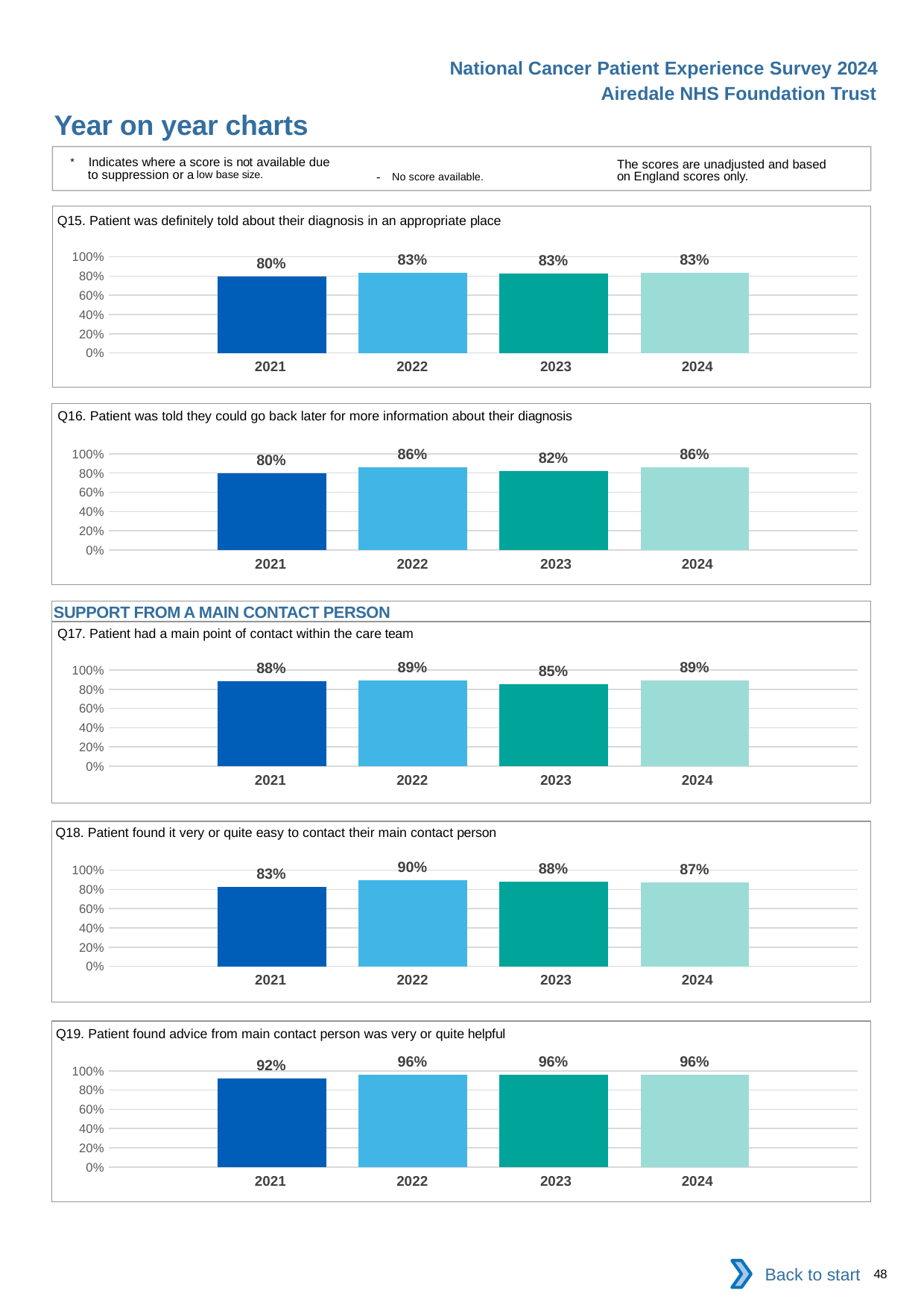
How many years are shown on the x axis of the Q15 chart (Patient was definitely told about their diagnosis in an appropriate place)? 4 In the Q18 chart (Patient found it very or quite easy to contact their main contact person), what is the difference between the 2022 and 2021 values? 7 percentage points In the Q19 chart (Patient found advice from main contact person was very or quite helpful), what is the value for 2021? 92% In the Q15 chart (Patient was definitely told about their diagnosis in an appropriate place), what is the value for 2021? 80% In the Q18 chart (Patient found it very or quite easy to contact their main contact person), which year has the highest value? 2022 What is the section heading shown above the Q17 chart? SUPPORT FROM A MAIN CONTACT PERSON In the Q19 chart (Patient found advice from main contact person was very or quite helpful), is the value for 2024 greater or less than 80%? greater In the Q16 chart (Patient was told they could go back later for more information about their diagnosis), what is the difference between the 2022 and 2023 values? 4 percentage points In the Q17 chart (Patient had a main point of contact within the care team), what is the value for 2023? 85% In the Q16 chart (Patient was told they could go back later for more information about their diagnosis), which year has the lowest value? 2021 In the Q17 chart (Patient had a main point of contact within the care team), which is larger, the value for 2021 or the value for 2023? 2021 What kind of chart is the Q18 chart (Patient found it very or quite easy to contact their main contact person)? Bar chart